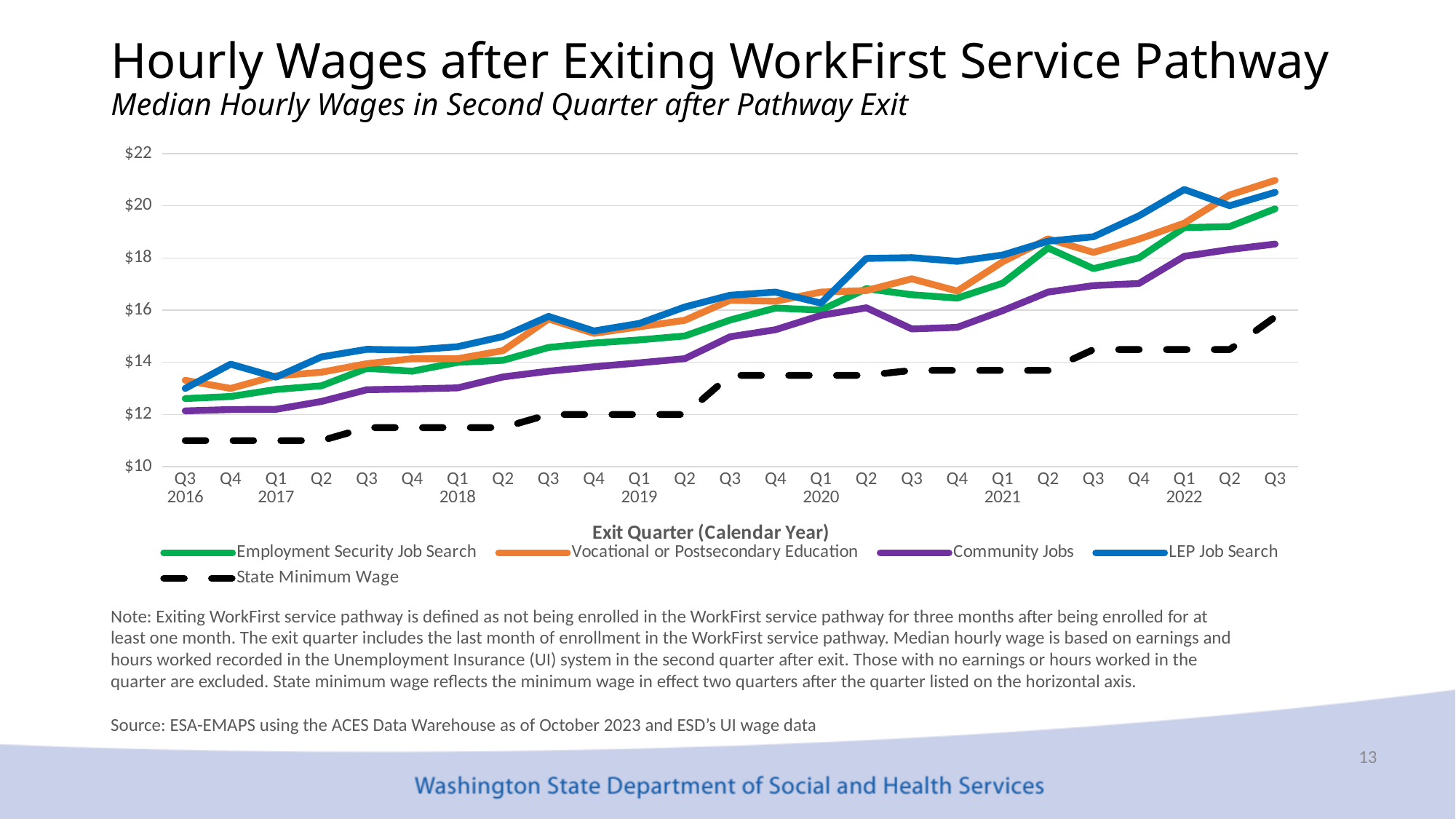
How many exit quarters are plotted along the x axis? 25 Is the value for LEP Job Search at Q1 2022 greater or less than $20? greater Which series has the highest value at Q3 2022? Vocational or Postsecondary Education Is the value for State Minimum Wage at Q3 2016 greater or less than $12? less How many series does the legend list? 5 Which series has the lowest value at Q3 2022? State Minimum Wage At Q3 2022, which is higher: Vocational or Postsecondary Education or Community Jobs? Vocational or Postsecondary Education What kind of chart is shown on the slide? Line chart Is the value for Community Jobs at Q3 2022 greater or less than $18? greater Do the Community Jobs values generally rise or fall from Q3 2016 to Q3 2022? Rise Which series is drawn as a dashed line? State Minimum Wage